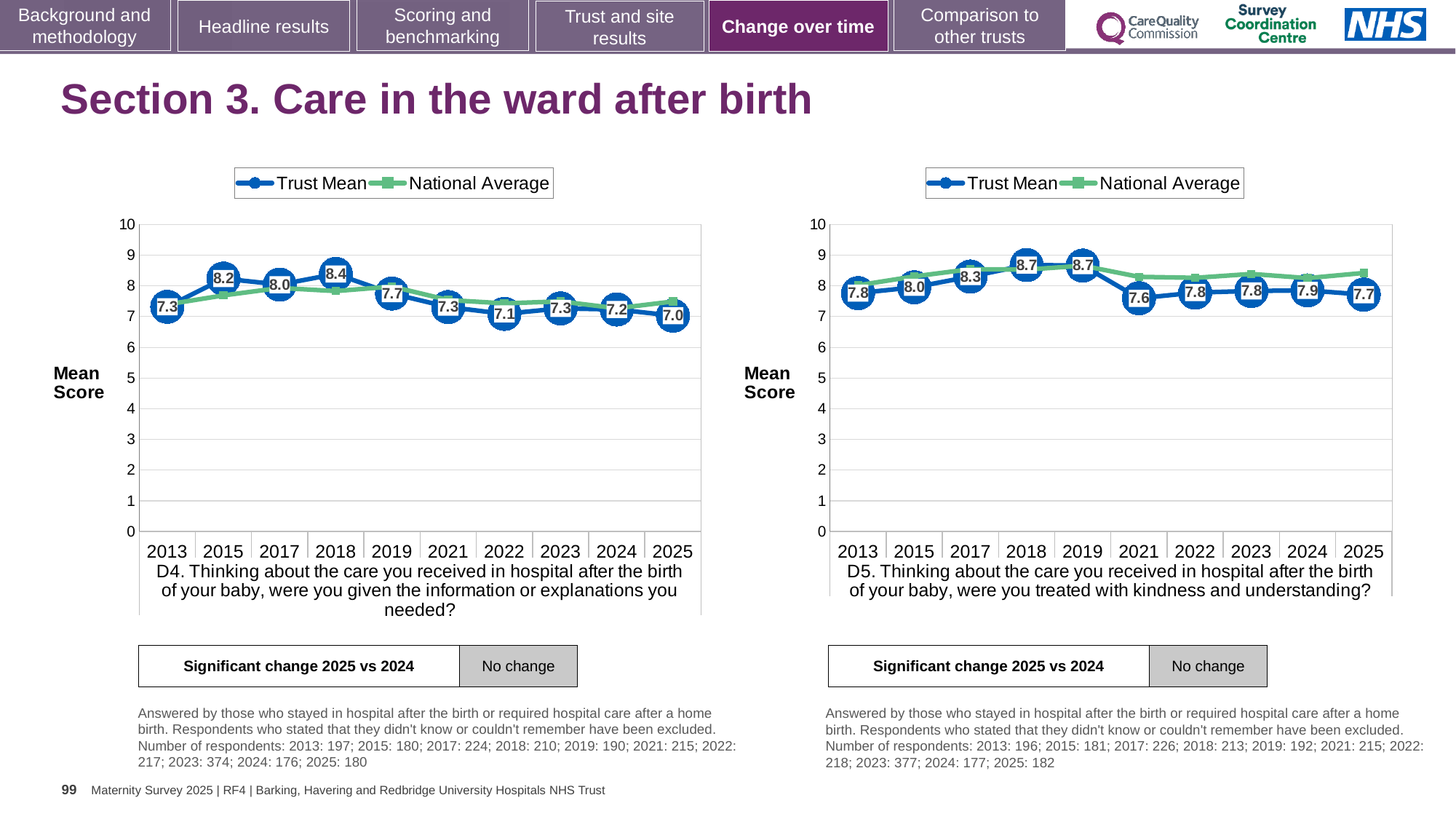
On the D5 chart (right), what is the Trust Mean score for 2021? 7.6 On the D4 chart (left), what is the Trust Mean score for 2018? 8.4 On the D5 chart (right), is the National Average value for 2025 greater or less than 8? greater On the D5 chart (right), what is the Trust Mean score for 2024? 7.9 On the D5 chart (right), in which year is the Trust Mean lowest? 2021 On the D4 chart (left), in which year is the Trust Mean highest? 2018 On the D4 chart (left), what is the difference between the Trust Mean in 2018 and in 2025? 1.4 On the D4 chart (left), in which year is the Trust Mean lowest? 2025 How many years are plotted on the D4 chart (left)? 10 On the D4 chart (left), what is the Trust Mean score for 2025? 7.0 How many series does the legend of the D5 chart (right) list? 2 On the D5 chart (right), is the Trust Mean higher in 2017 or in 2025? 2017